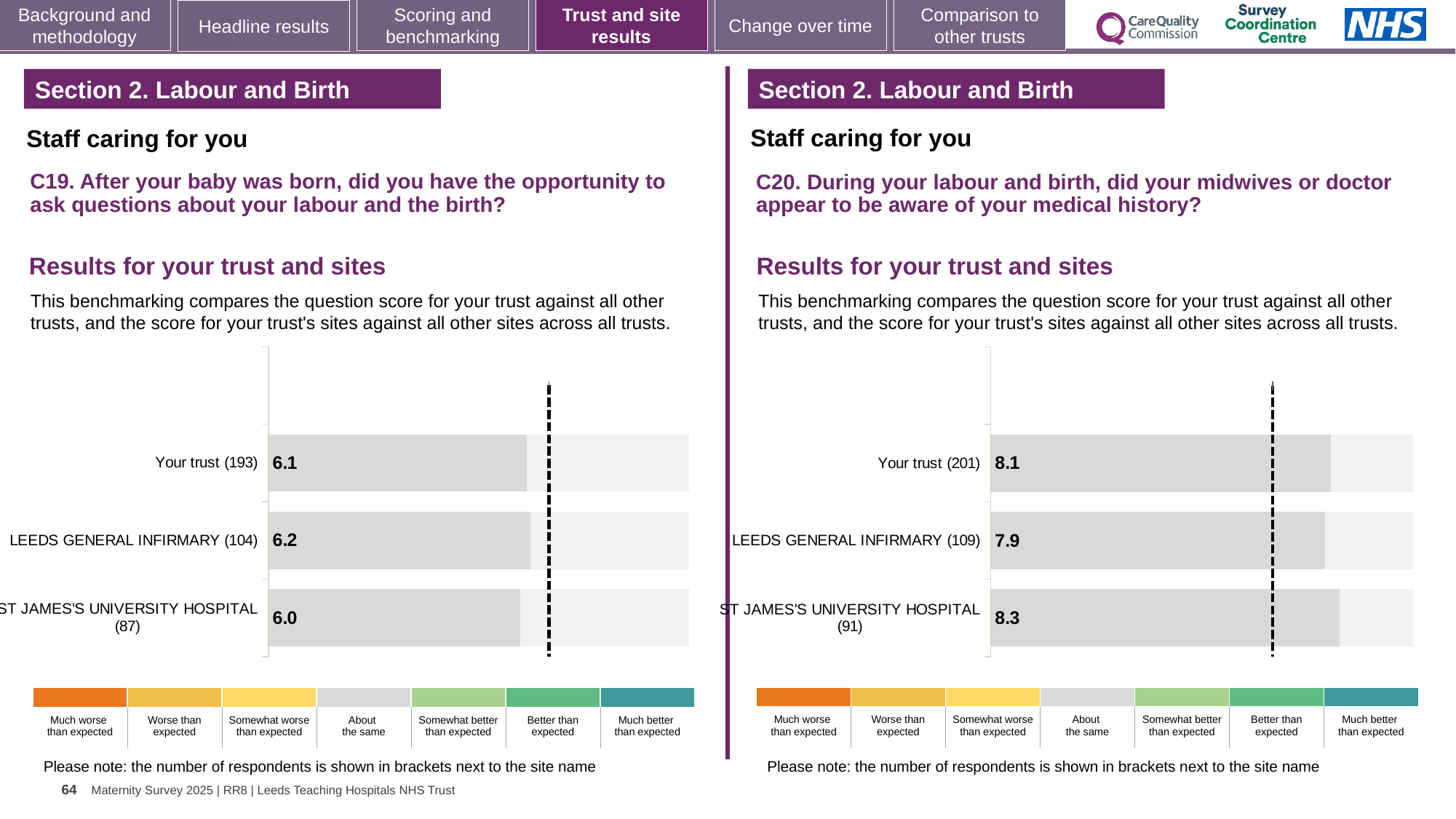
In the C19 chart on the left, what is the score for LEEDS GENERAL INFIRMARY (104)? 6.2 In the C19 chart on the left, which site or trust has the highest score? LEEDS GENERAL INFIRMARY (104) In the C19 chart on the left, what is the score for Your trust (193)? 6.1 In the C19 chart on the left, how many bars are plotted? 3 In the C19 chart on the left, what is the score for ST JAMES'S UNIVERSITY HOSPITAL (87)? 6.0 In the C19 chart on the left, how many categories does the colour legend below the chart list? 7 In the C20 chart on the right, what is the score for ST JAMES'S UNIVERSITY HOSPITAL (91)? 8.3 In the C20 chart on the right, which site or trust has the lowest score? LEEDS GENERAL INFIRMARY (109) In the C20 chart on the right, what is the difference between the scores for ST JAMES'S UNIVERSITY HOSPITAL (91) and LEEDS GENERAL INFIRMARY (109)? 0.4 In the C20 chart on the right, what is the score for Your trust (201)? 8.1 What type of chart is used in the C20 chart on the right? Bar chart In the C20 chart on the right, what is the score for LEEDS GENERAL INFIRMARY (109)? 7.9